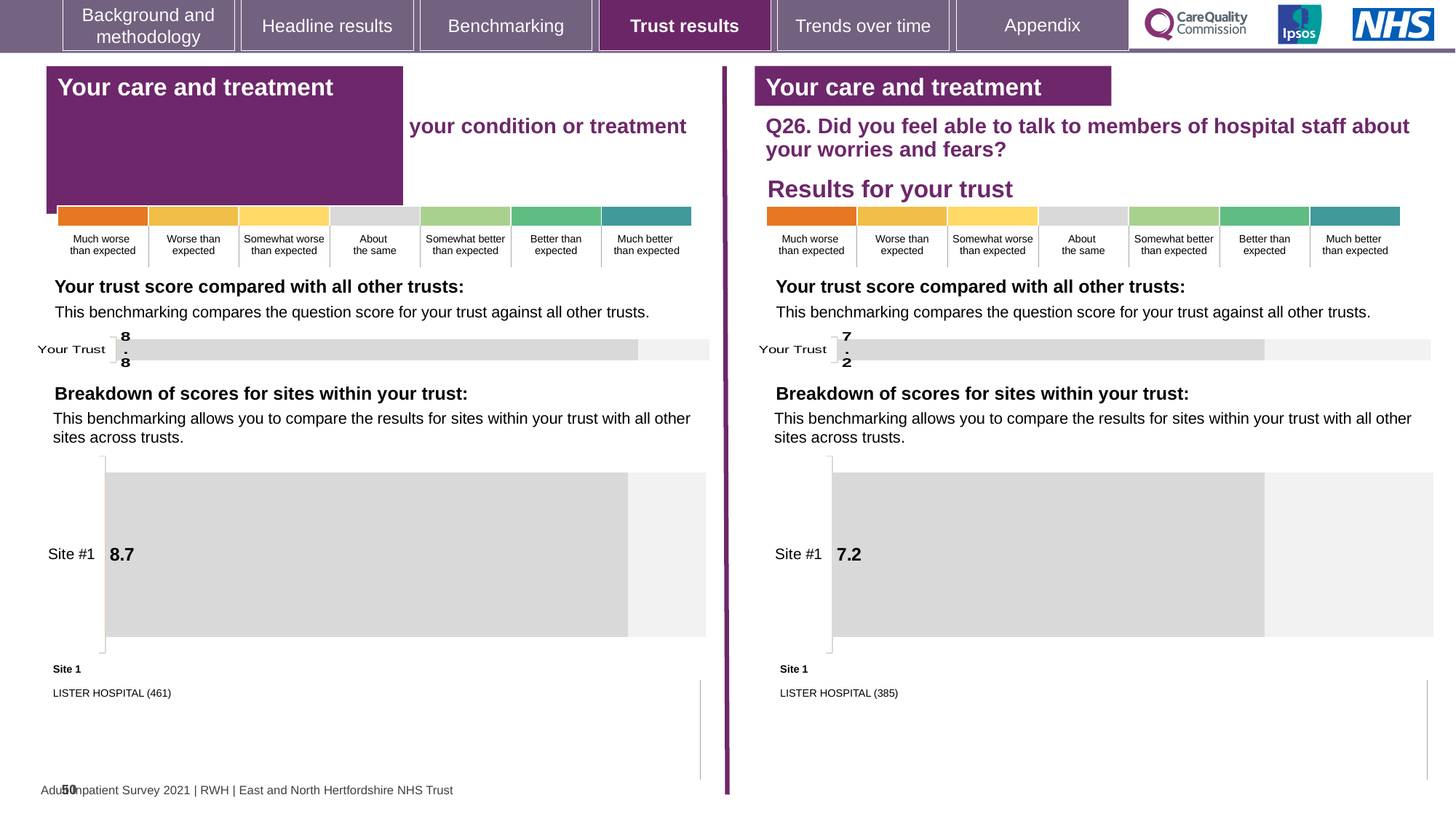
Which is larger: the trust score on the left panel or the trust score on the right panel (Q26)? Left panel (8.8) What is the difference between the Site #1 score on the left panel and the Site #1 score on the right panel (Q26)? 1.5 On the left panel, what is the score for Site #1 in the 'Breakdown of scores for sites within your trust' chart? 8.7 Is the Site #1 score on the right panel (Q26) greater or less than the Site #1 score on the left panel? less On the right panel (Q26), which hospital is listed as Site 1? LISTER HOSPITAL (385) How many sites are shown in the 'Breakdown of scores for sites within your trust' chart on the right panel (Q26)? 1 On the left panel, what is the trust score shown in the 'Your trust score compared with all other trusts' chart? 8.8 On the right panel (Q26), what is the trust score shown in the 'Your trust score compared with all other trusts' chart? 7.2 What type of chart is used to show the Site #1 score on the left panel? Bar chart On the right panel (Q26), what is the score for Site #1 in the 'Breakdown of scores for sites within your trust' chart? 7.2 On the left panel, which hospital is listed as Site 1? LISTER HOSPITAL (461) On the left panel, what is the difference between the trust score and the Site #1 score? 0.1